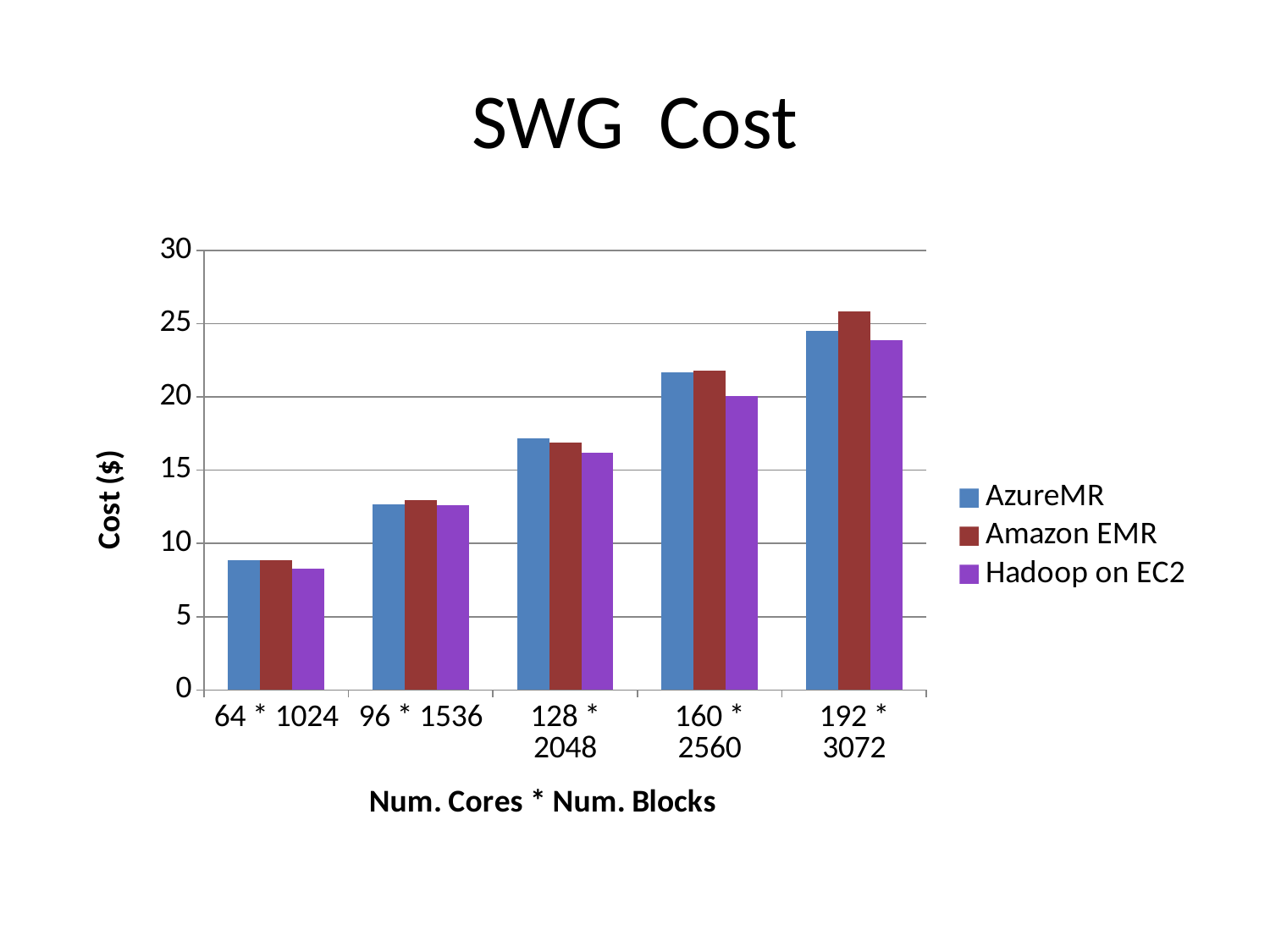
For Amazon EMR, which category has the highest cost? 192 * 3072 Do the AzureMR costs rise or fall as Num. Cores * Num. Blocks increases along the x axis? rise Is the Hadoop on EC2 cost for 192 * 3072 greater or less than 25? less For Hadoop on EC2, which category has the lowest cost? 64 * 1024 What kind of chart is shown on the slide? bar chart Is the Amazon EMR cost for 192 * 3072 greater or less than 25? greater At 160 * 2560, which is larger: the AzureMR cost or the Hadoop on EC2 cost? AzureMR What is the title of the y axis? Cost ($) At 192 * 3072, which is larger: the Amazon EMR cost or the Hadoop on EC2 cost? Amazon EMR Is the AzureMR cost for 64 * 1024 greater or less than 10? less How many categories are shown on the x axis? 5 How many series does the legend list? 3